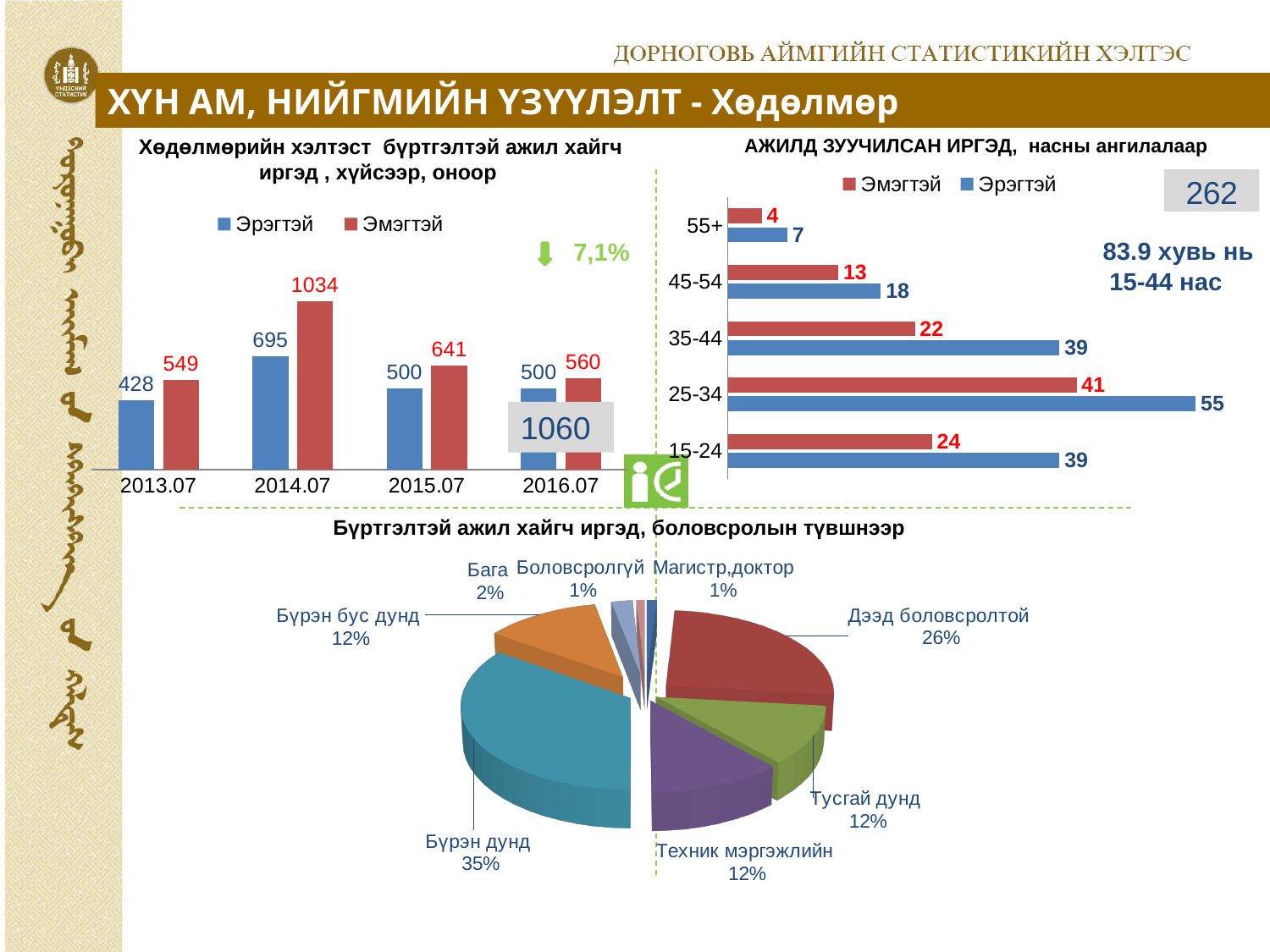
In the top-left chart (Хөдөлмөрийн хэлтэст бүртгэлтэй ажил хайгч иргэд), what is the value for Эмэгтэй in 2014.07? 1034 In the bottom pie chart (Бүртгэлтэй ажил хайгч иргэд, боловсролын түвшнээр), what share does Бүрэн дунд have? 35% In the top-right chart, how many age groups are shown? 5 In the top-left chart, what is the difference between the Эмэгтэй and Эрэгтэй values in 2016.07? 60 What type of chart is the bottom chart on the slide? Pie chart In the top-left chart, how many series does the legend list? 2 In the top-left chart, what is the value for Эрэгтэй in 2013.07? 428 In the top-right chart, what is the Эмэгтэй value for the 55+ age group? 4 In the top-right chart, which age group has the lowest Эрэгтэй value? 55+ In the top-right chart, which is larger for the 15-24 age group: Эмэгтэй or Эрэгтэй? Эрэгтэй In the top-right chart (АЖИЛД ЗУУЧИЛСАН ИРГЭД, насны ангилалаар), what is the Эрэгтэй value for the 25-34 age group? 55 In the top-left chart, in which year is the Эмэгтэй value highest? 2014.07